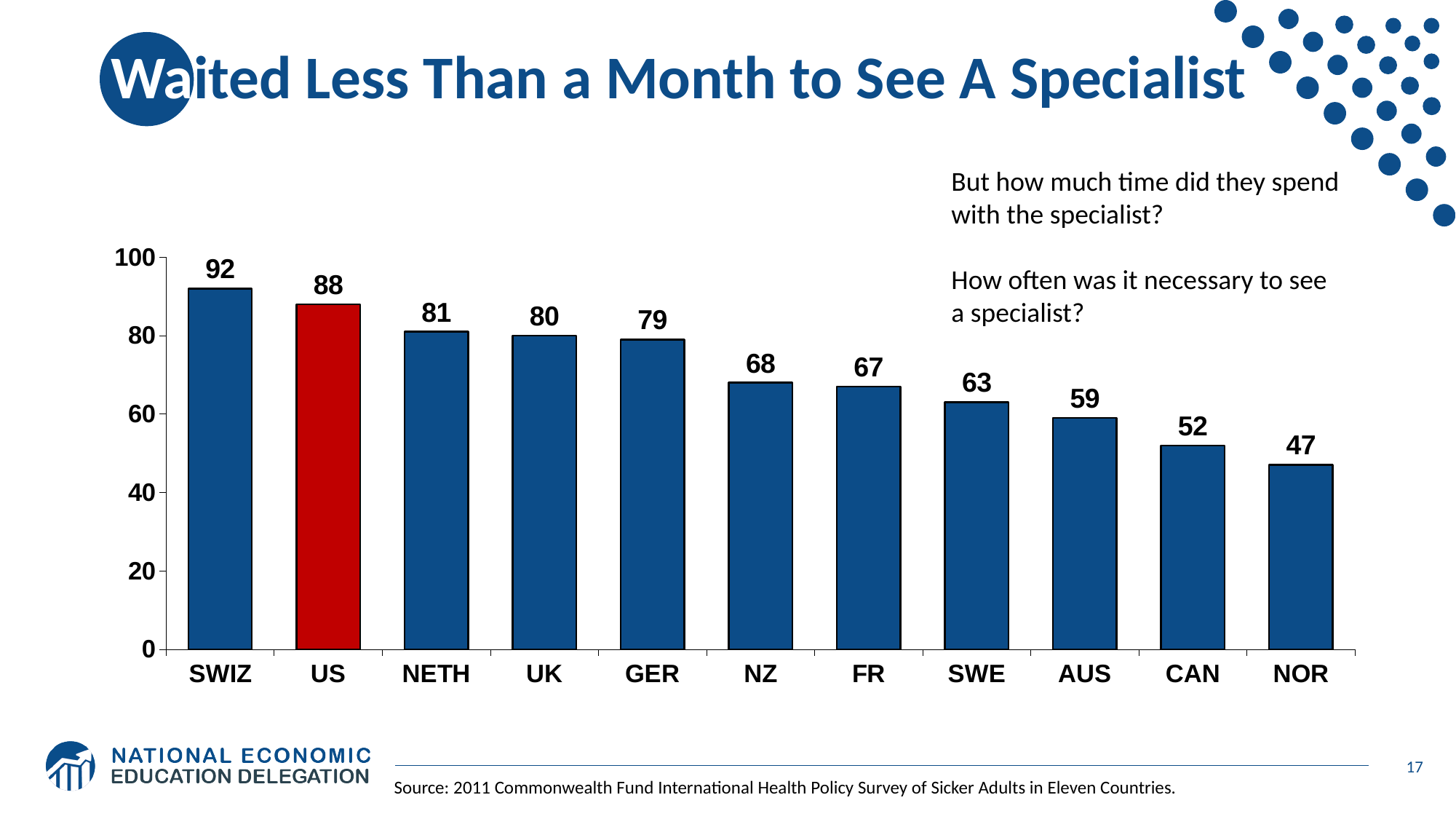
What is the value for CAN? 52 What is the value for GER? 79 Which country has the highest value? SWIZ What is the value for the US? 88 Is the value for AUS greater or less than 60? less What is the difference between the values for US and NETH? 7 What kind of chart is shown on the slide? bar chart Which has a larger value, NZ or SWE? NZ What is the difference between the values for SWIZ and NOR? 45 How many countries are shown on the chart? 11 Which bar is coloured red rather than blue? US Which country has the lowest value? NOR